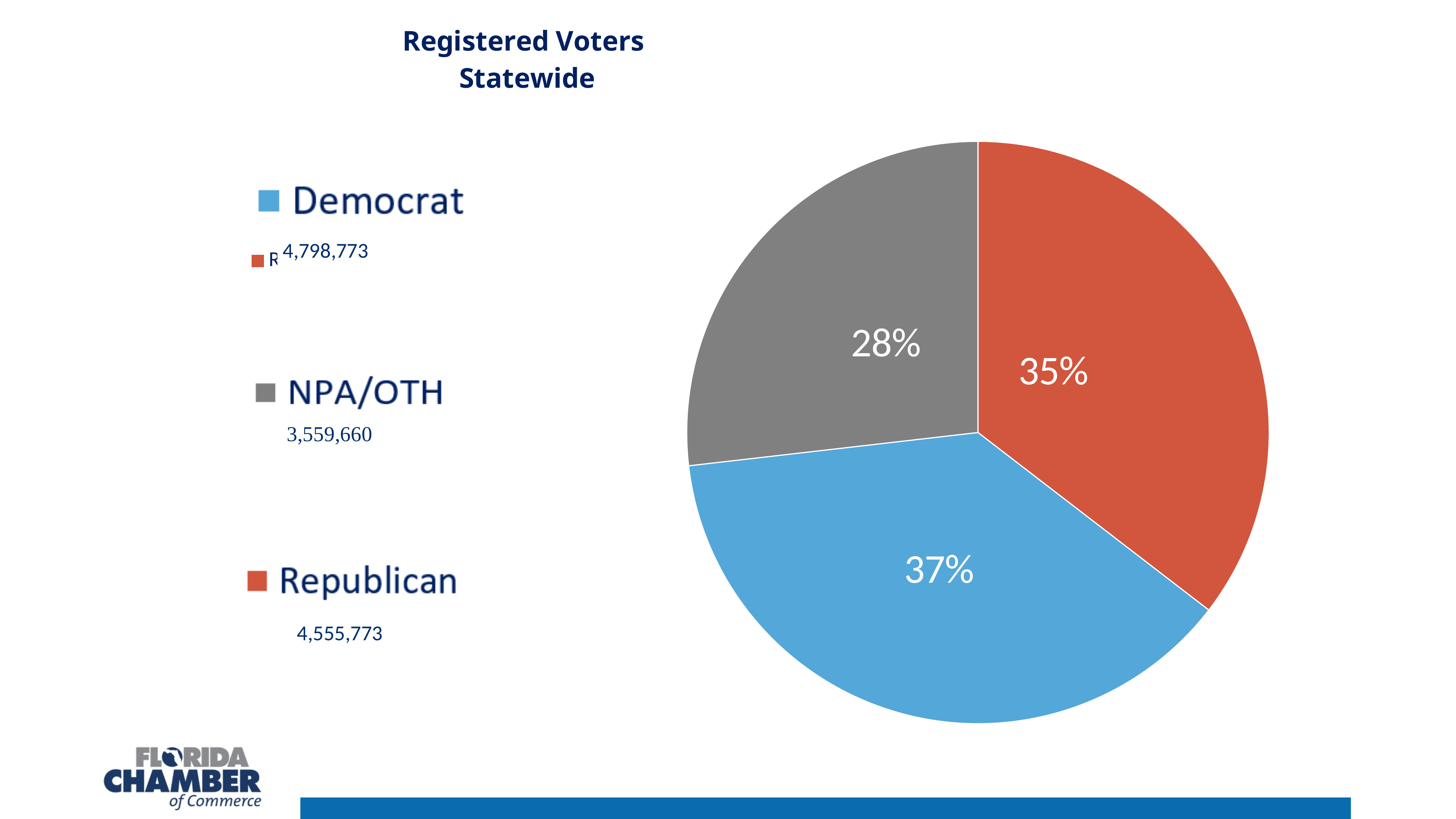
How many registered Republican voters are shown on the slide? 4,555,773 What colour is the Republican slice of the pie? orange-red Which category has the smallest share of the pie? NPA/OTH What is the difference in percentage points between the Democrat and NPA/OTH shares? 9 Which category has the largest share of the pie? Democrat How many registered Democrat voters are shown on the slide? 4,798,773 How many slices does the pie chart have? 3 How many NPA/OTH registered voters are shown on the slide? 3,559,660 What percentage of registered voters statewide are Democrats? 37% What percentage of registered voters statewide are Republicans? 35% What percentage of registered voters statewide are NPA/OTH? 28% What kind of chart is shown on the slide? pie chart